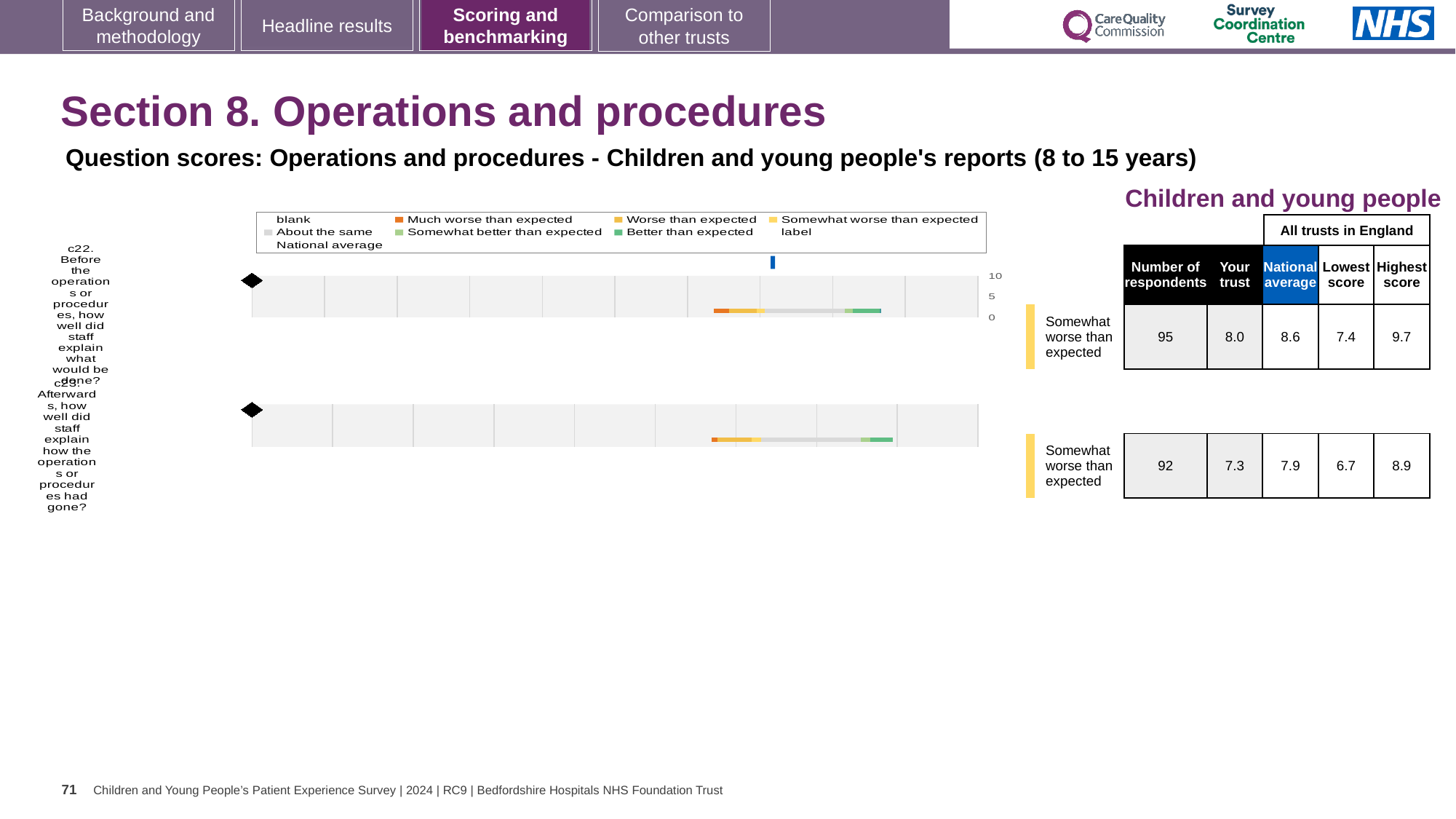
What benchmark category is shown for c23? Somewhat worse than expected How many entries does the chart legend list? 9 Which question has the higher 'Your trust' score, c22 or c23? c22 What is the national average score for c23 (Afterwards, how well did staff explain how the operations or procedures had gone)? 7.9 What kind of chart is used to show the question scores for c22 and c23? bar chart What is the lowest score among all trusts in England for c22? 7.4 What is the highest score among all trusts in England for c23? 8.9 How many questions (c22 and c23) are plotted on the slide? 2 What is the difference between the national average and the trust's score for c22? 0.6 What is the difference between the highest and lowest scores for c23? 2.2 What is the 'Your trust' score for c22 (Before the operations or procedures, how well did staff explain what would be done)? 8.0 How many respondents answered c22? 95